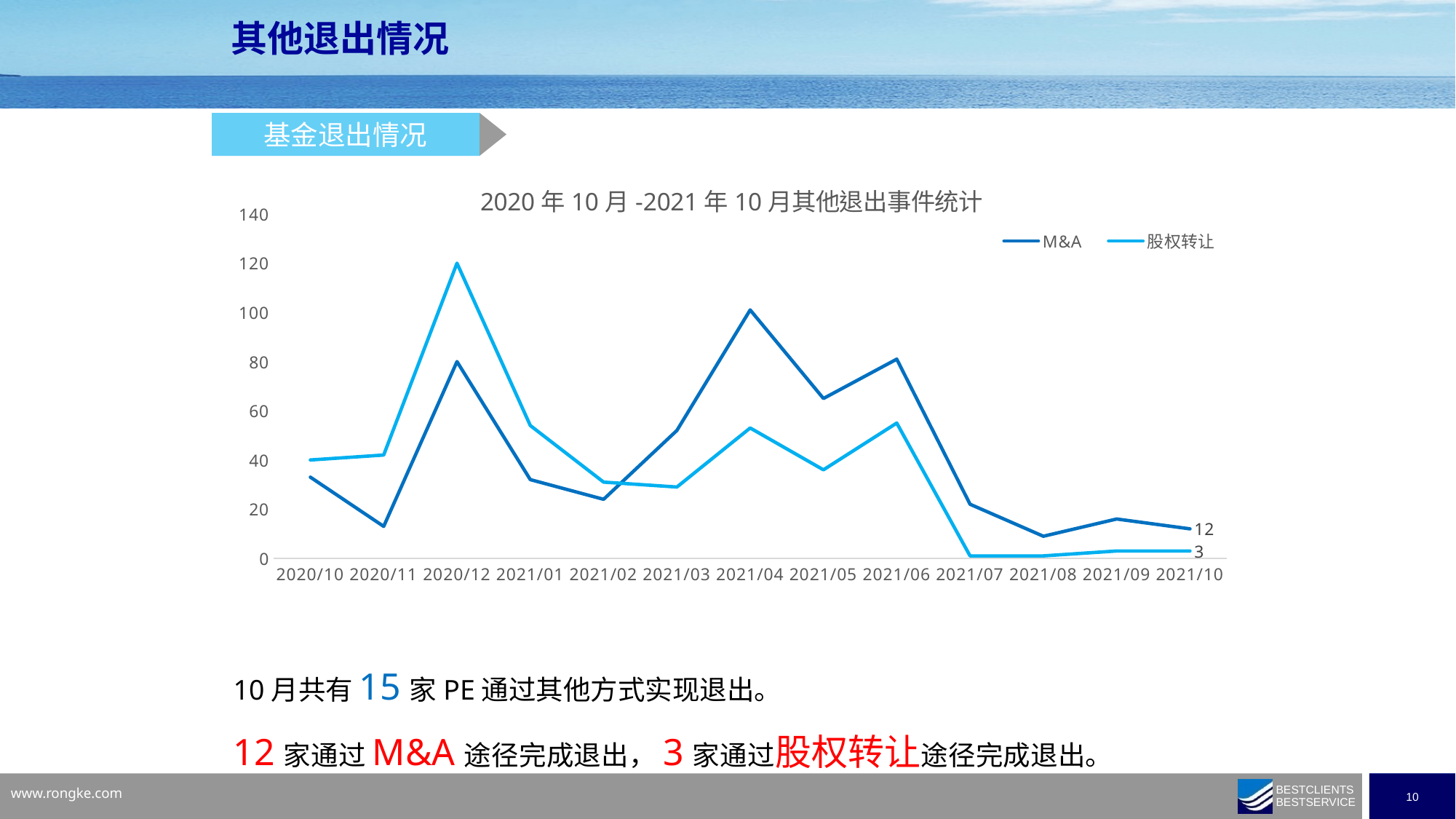
What is the difference between the M&A and 股权转让 values at 2021/10? 9 What is the value for M&A at 2021/10? 12 At 2020/12, which series has the larger value, M&A or 股权转让? 股权转让 Is the value for M&A at 2021/07 greater or less than 40? less How many months are plotted on the x axis? 13 In which month does the 股权转让 series reach its highest value? 2020/12 What kind of chart is shown on the slide? line chart How many series does the legend list? 2 In which month does the M&A series reach its highest value? 2021/04 At 2021/04, which series has the larger value, M&A or 股权转让? M&A Is the value for 股权转让 at 2020/12 greater or less than 100? greater What is the value for 股权转让 at 2021/10? 3